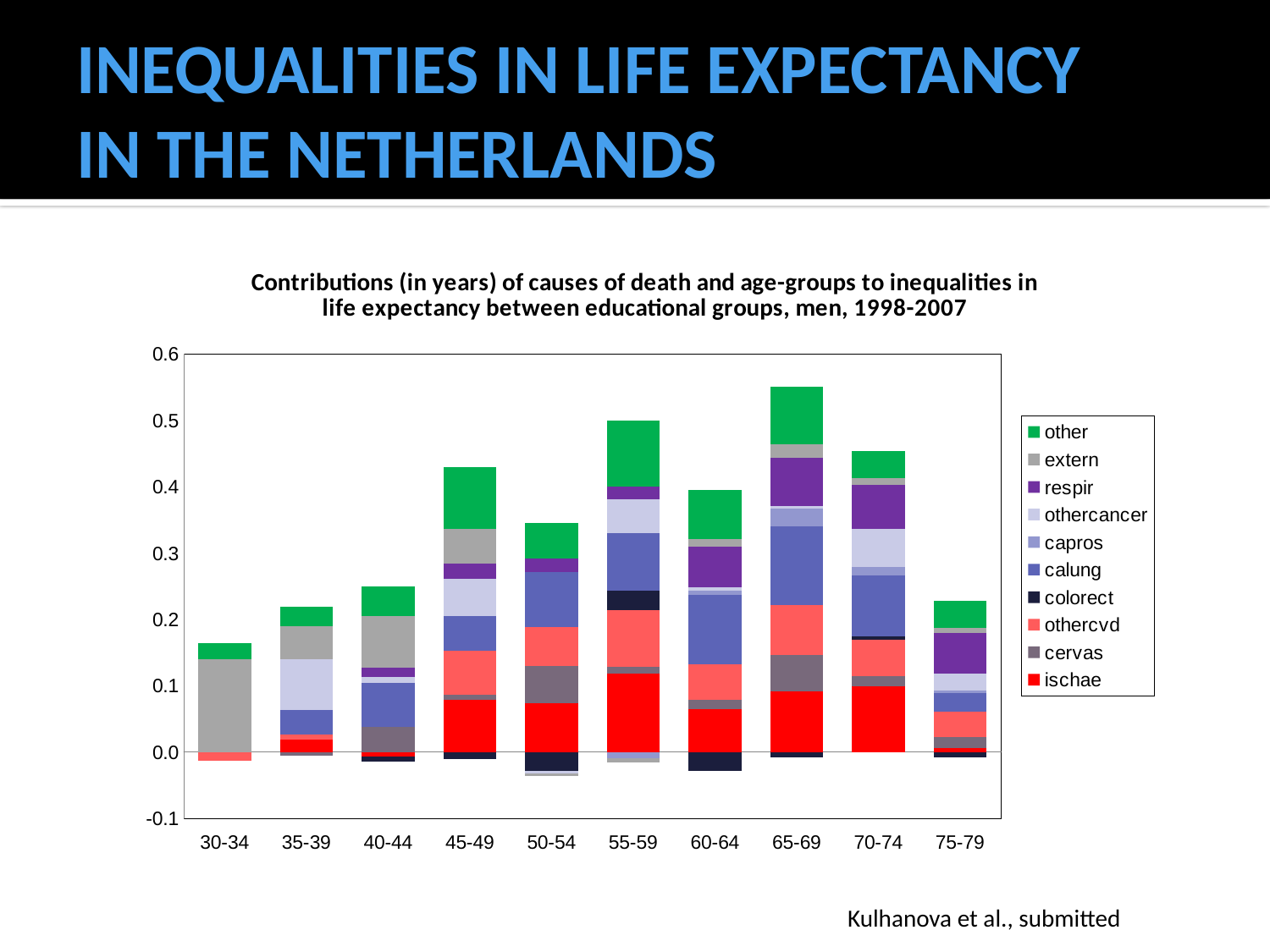
What kind of chart is shown on the slide? Stacked bar chart Which stacked bar reaches higher, 65-69 or 70-74? 65-69 Which cause of death is shown in red in the legend? ischae How many age-group categories are shown on the x axis? 10 Is the top of the stacked bar for 65-69 greater or less than 0.5? greater How many series does the legend list? 10 Which age group has the tallest stacked bar? 65-69 Which age group has the shortest stacked bar? 30-34 Is the top of the stacked bar for 45-49 greater or less than 0.4? greater Is the top of the stacked bar for 30-34 greater or less than 0.2? less Which stacked bar reaches higher, 45-49 or 50-54? 45-49